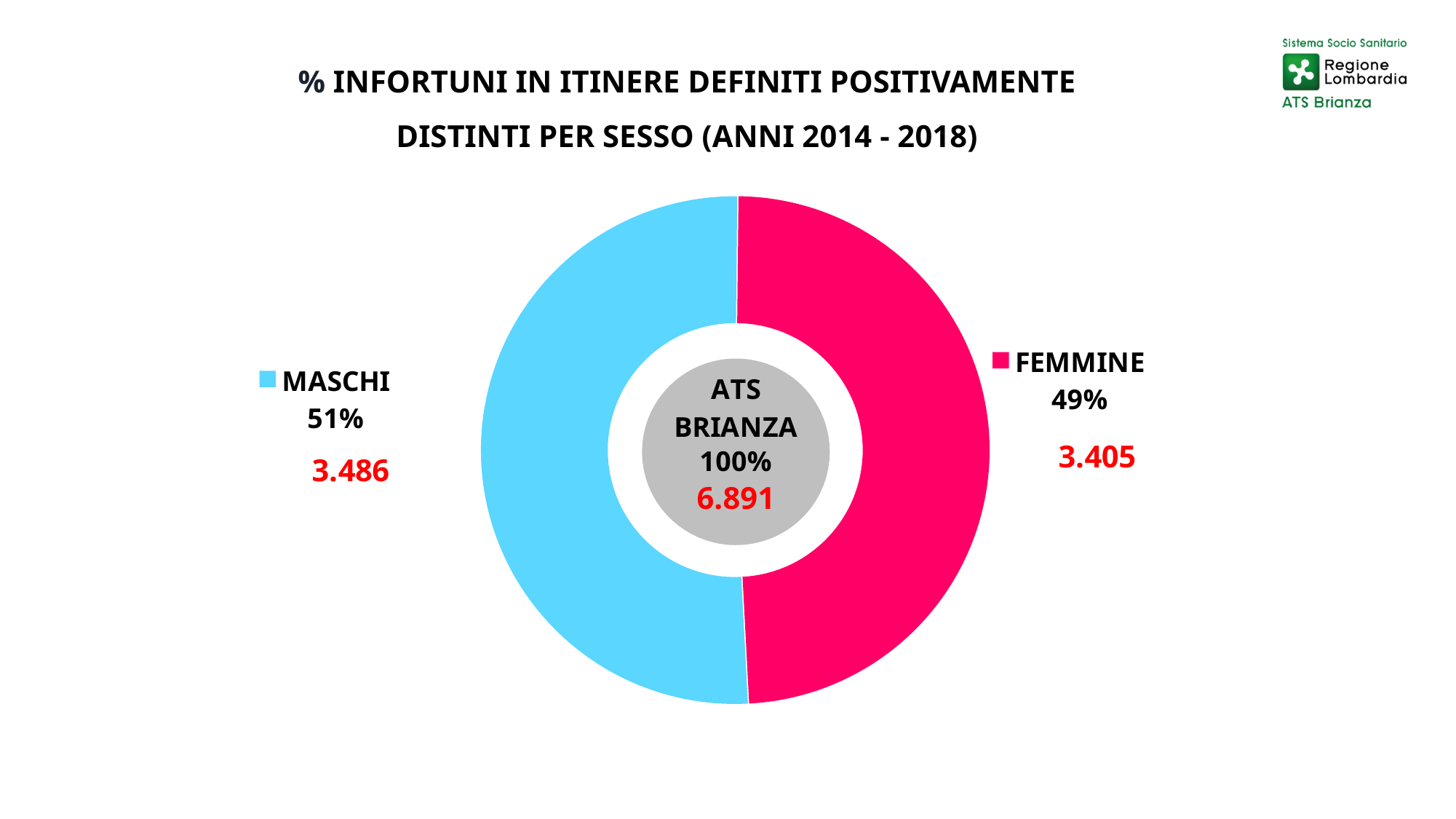
What colour is the MASCHI slice? Light blue What years does the chart title say the data covers? 2014 - 2018 What kind of chart is shown on the slide? Pie chart (doughnut) What count is shown in red next to MASCHI? 3.486 What is the difference in percentage points between the MASCHI and FEMMINE shares? 2 What total count is shown in the centre of the chart for ATS BRIANZA? 6.891 What percentage of the chart is labelled FEMMINE? 49% What count is shown in red next to FEMMINE? 3.405 Which category has the smallest share of the chart? FEMMINE Which category has the larger share of the chart, MASCHI or FEMMINE? MASCHI How many categories does the chart show? 2 What percentage of the chart is labelled MASCHI? 51%